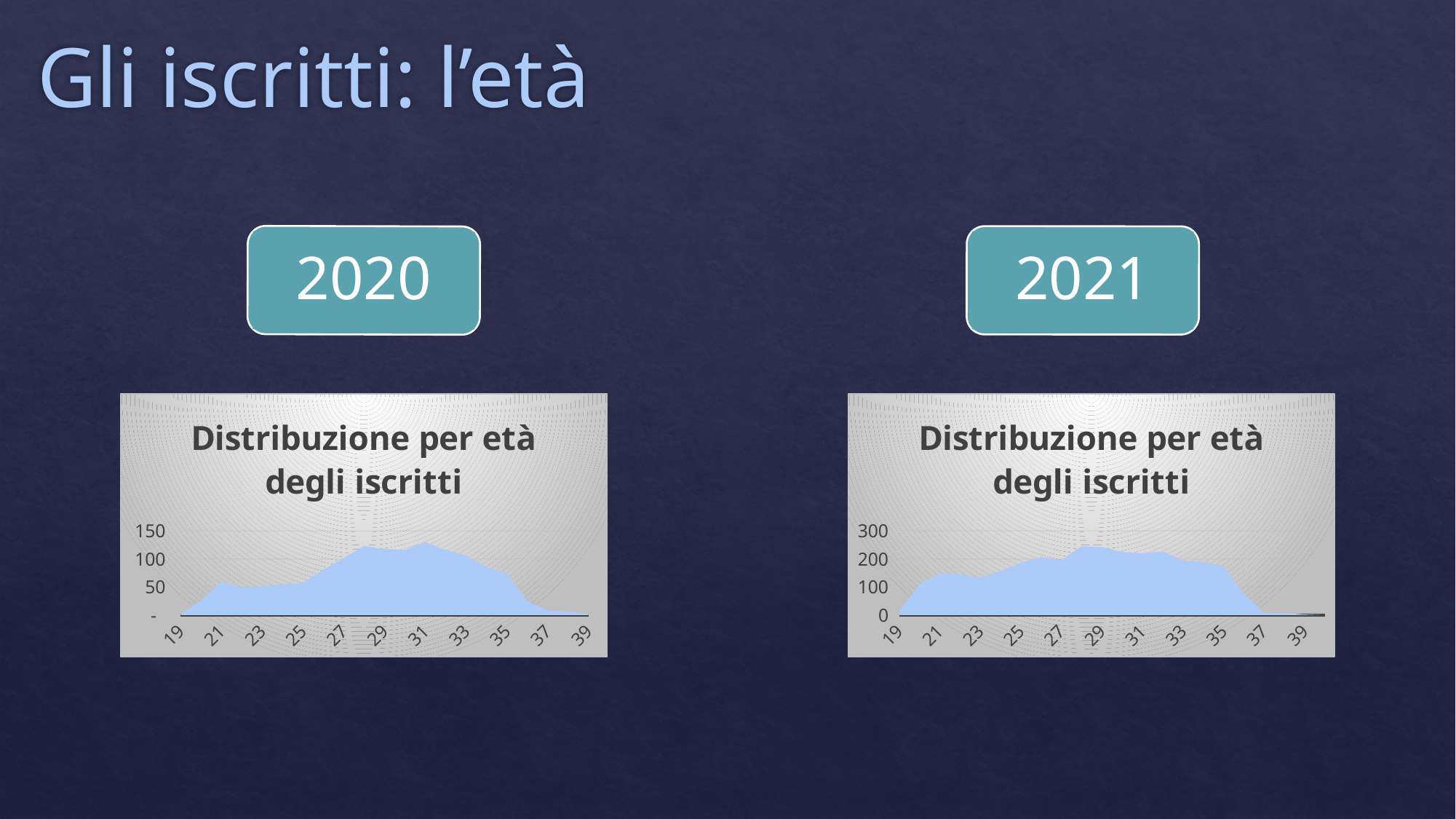
In the 2020 chart on the left, is the value at age 25 greater or less than 100? less What kind of chart is the 2020 chart on the left? area chart In the 2021 chart on the right, is the value at age 39 greater or less than 100? less How many age labels are shown on the x axis of the 2020 chart on the left? 11 In the 2021 chart on the right, is the value at age 29 greater or less than 200? greater What is the title of the 2021 chart on the right? Distribuzione per età degli iscritti In the 2021 chart on the right, do the values rise or fall from age 19 to age 29? rise What is the highest value shown on the y axis of the 2021 chart on the right? 300 In the 2021 chart on the right, do the values rise or fall from age 35 to age 39? fall